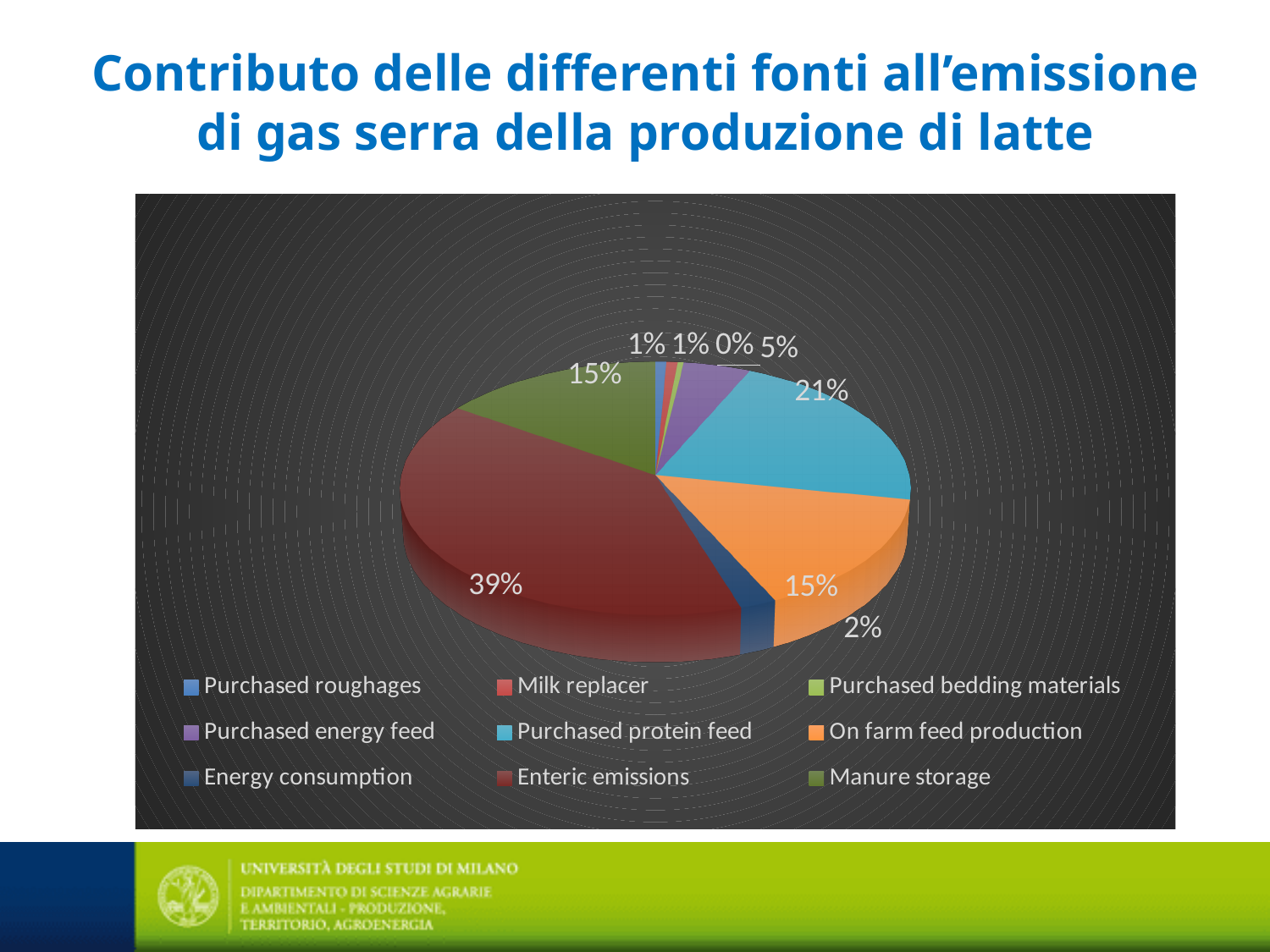
Which is larger, the share for Purchased protein feed or the share for Manure storage? Purchased protein feed What kind of chart is shown on the slide? pie chart What is the value shown for On farm feed production? 15% What is the value shown for Purchased energy feed? 5% How many entries does the legend of the pie chart list? 9 What is the difference in percentage points between Enteric emissions and Purchased protein feed? 18 percentage points What share of the pie does Purchased protein feed account for? 21% How many slices does the pie chart have? 9 Which source has the largest share of greenhouse gas emissions in the pie chart? Enteric emissions What share of the pie does Enteric emissions account for? 39% What is the value shown for Energy consumption? 2% Which source has the smallest share in the pie chart? Purchased bedding materials